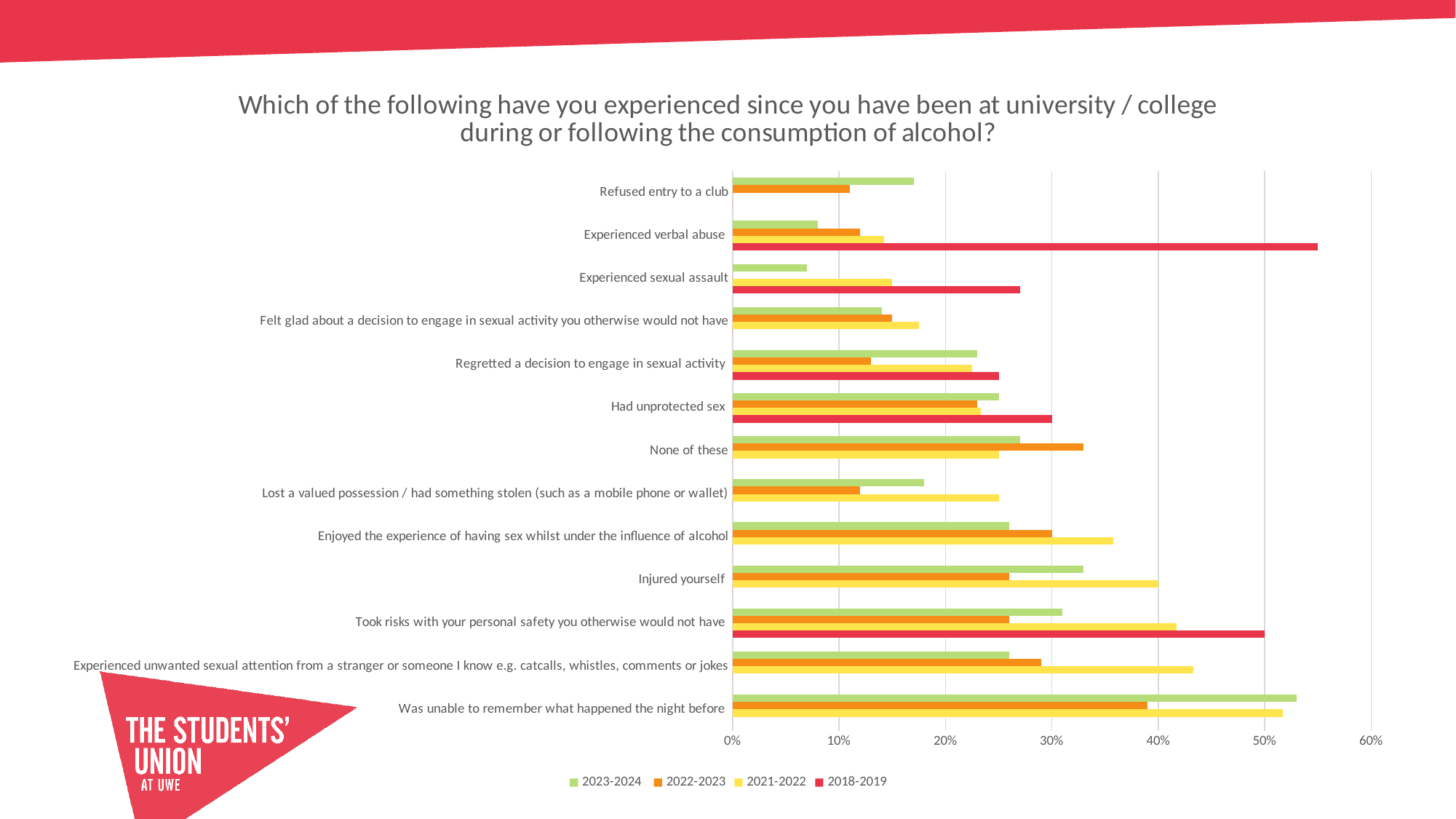
How many series does the legend list? 4 Which series is shown in red in the legend? 2018-2019 How many categories are plotted on the chart? 13 Is the 2018-2019 value for 'Experienced verbal abuse' greater or less than 50%? greater Which category has the highest 2018-2019 value? Experienced verbal abuse For 'None of these', which is larger: the 2022-2023 value or the 2023-2024 value? 2022-2023 Is the 2021-2022 value for 'Injured yourself' greater or less than 30%? greater What kind of chart is shown on the slide? Bar chart Is the 2022-2023 value for 'Refused entry to a club' greater or less than 20%? less Which category has the highest 2023-2024 value? Was unable to remember what happened the night before For 'Took risks with your personal safety you otherwise would not have', which is larger: the 2018-2019 value or the 2023-2024 value? 2018-2019